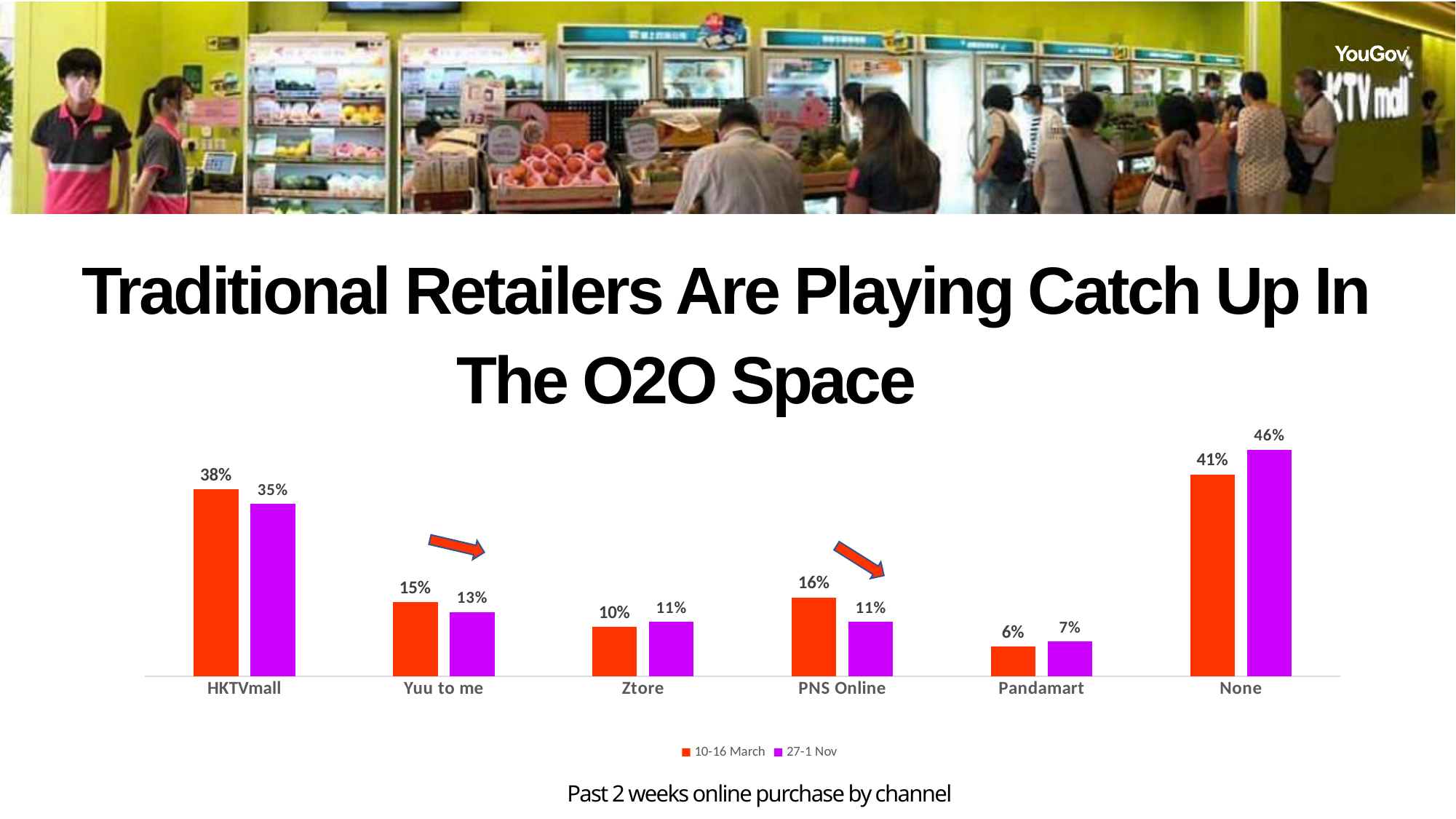
Which is larger for Ztore: the 10-16 March value or the 27-1 Nov value? 27-1 Nov What is the value for None in the 27-1 Nov series? 46% What is the value for PNS Online in the 27-1 Nov series? 11% What kind of chart is shown on the slide? Bar chart What is the value for HKTVmall in the 10-16 March series? 38% What colour are the bars for the 27-1 Nov series? Purple Which category has the lowest value in the 10-16 March series? Pandamart What is the difference between the 10-16 March and 27-1 Nov values for Yuu to me? 2% What is the difference between the 10-16 March and 27-1 Nov values for PNS Online? 5% How many categories are shown on the x axis? 6 Which category has the highest value in the 27-1 Nov series? None How many series does the legend list? 2